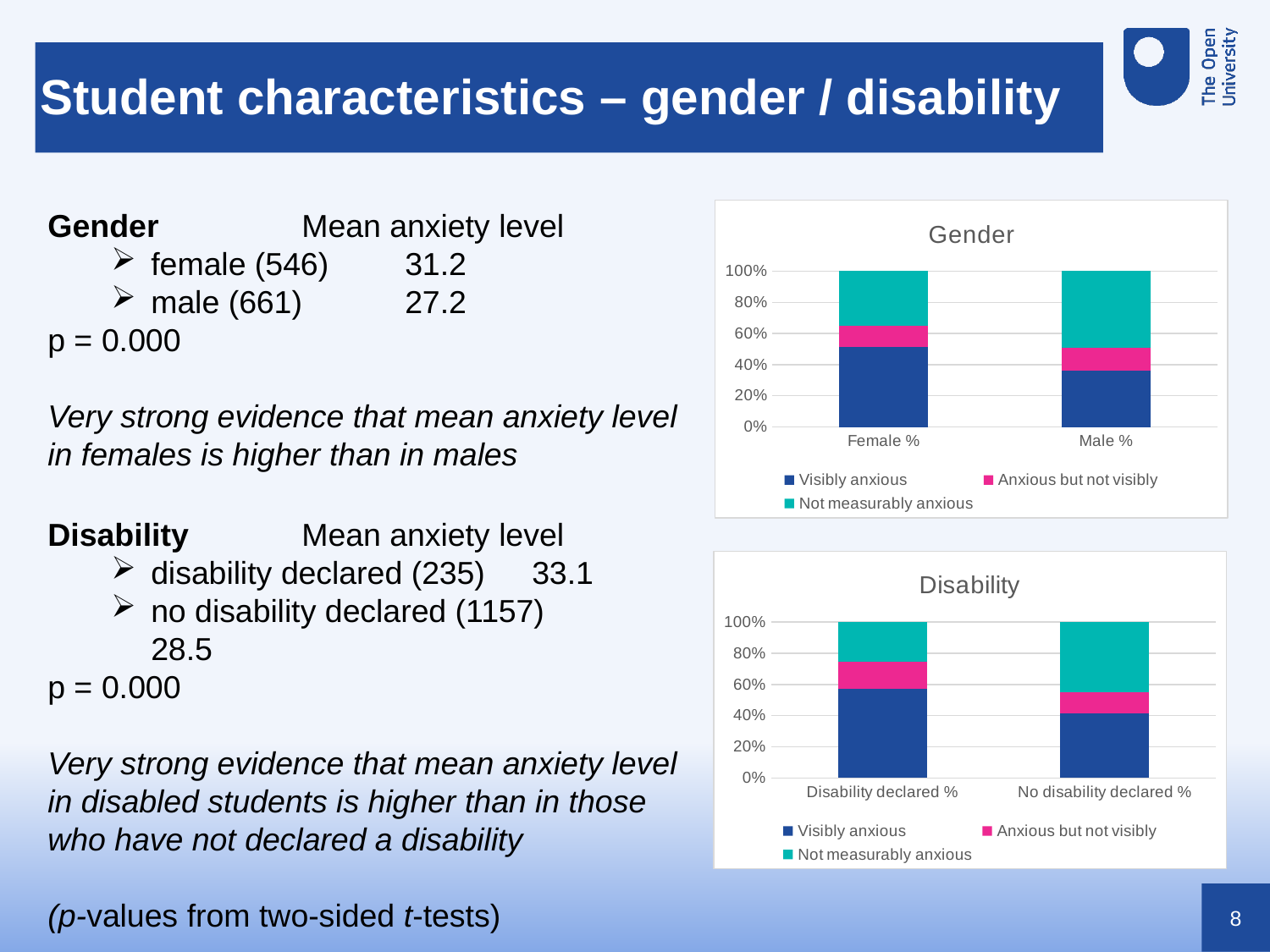
In the Gender chart, which category has the larger Visibly anxious share, Female % or Male %? Female % In the Disability chart, which category has the larger Visibly anxious share, Disability declared % or No disability declared %? Disability declared % In the Gender chart, is the Visibly anxious value for Male % greater or less than 40%? less In the Disability chart, is the Visibly anxious value for Disability declared % greater or less than 40%? greater How many categories are shown on the x axis of the Disability chart? 2 How many series does the legend of the Gender chart list? 3 What kind of chart is the Gender chart? stacked bar chart In the Gender chart, is the Visibly anxious value for Female % greater or less than 40%? greater In the Gender chart, which category has the larger Not measurably anxious share, Female % or Male %? Male % What is the title of the lower chart on the slide? Disability In the Disability chart, what is the total height of the Disability declared % stacked bar? 100%